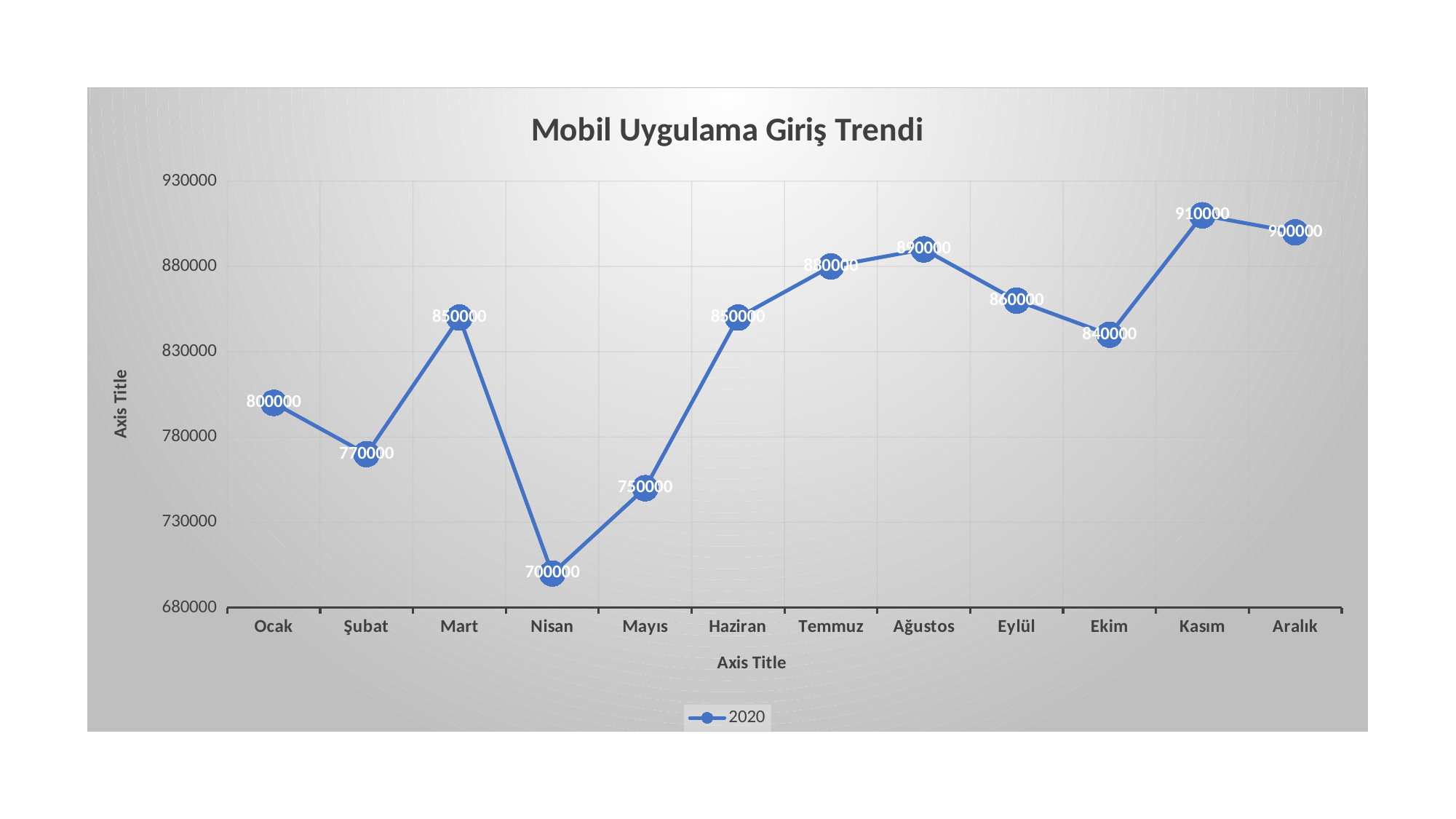
Do the values rise or fall from Haziran to Ağustos? rise What is the value for Ekim? 840000 What is the difference between the values for Kasım and Nisan? 210000 What is the value for Mart? 850000 What kind of chart is shown? line chart What is the title of the chart? Mobil Uygulama Giriş Trendi How many series does the legend list? 1 Which month has the highest value? Kasım How many months are plotted on the x axis? 12 Which month has the lowest value? Nisan Which is larger, the value for Şubat or the value for Mayıs? Şubat